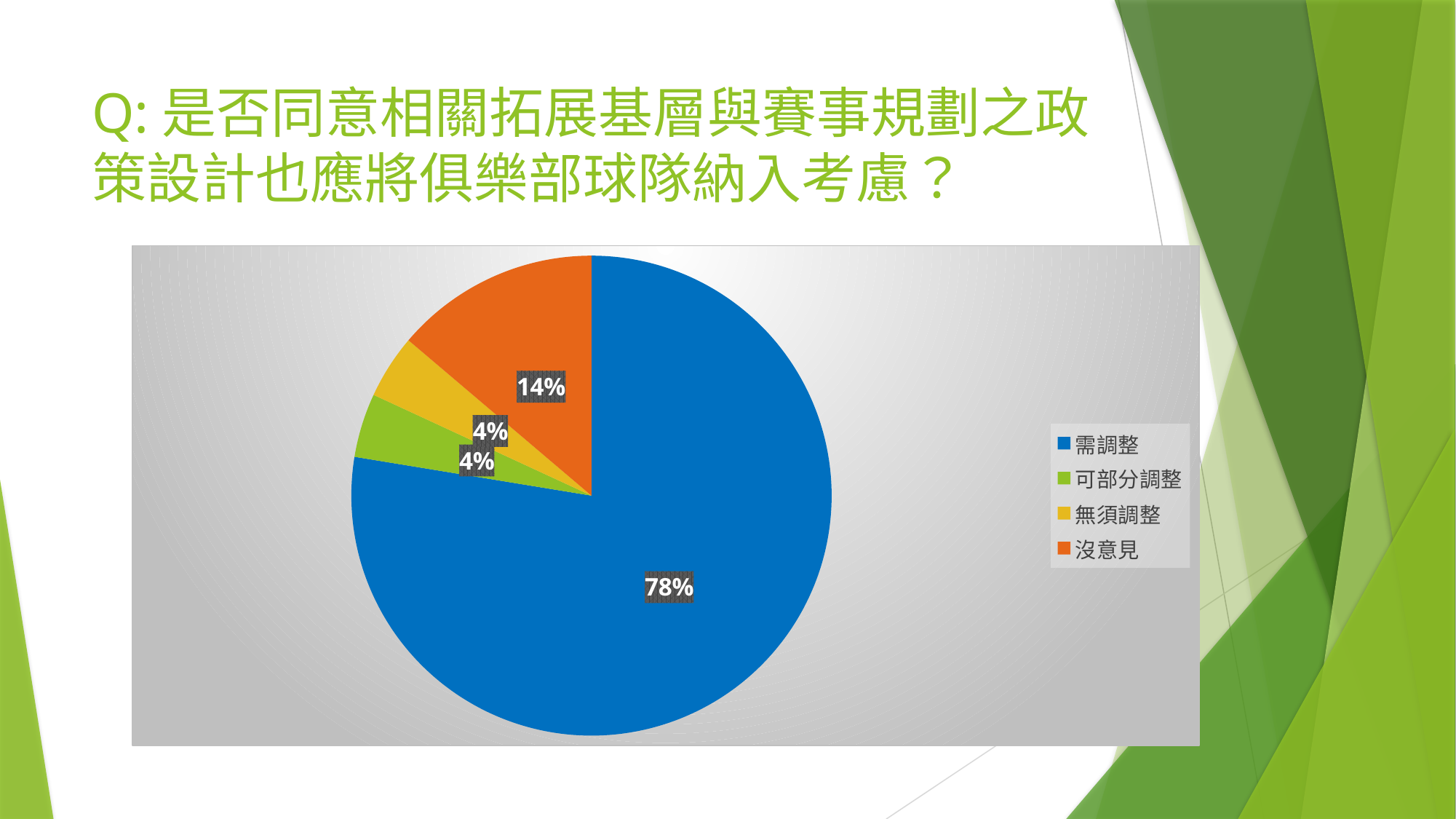
Which colour represents 沒意見 in the pie chart? orange What share of the pie does 沒意見 have? 14% Which is larger, the share of 沒意見 or the share of 無須調整? 沒意見 Which category has the largest slice of the pie? 需調整 How many entries does the legend list? 4 What share of the pie does 可部分調整 have? 4% What is the combined share of 可部分調整 and 無須調整? 8% How many categories does the pie chart show? 4 What is the difference between the shares of 需調整 and 沒意見? 64% What share of the pie does 無須調整 have? 4% What kind of chart is shown on the slide? pie chart What share of the pie does 需調整 have? 78%